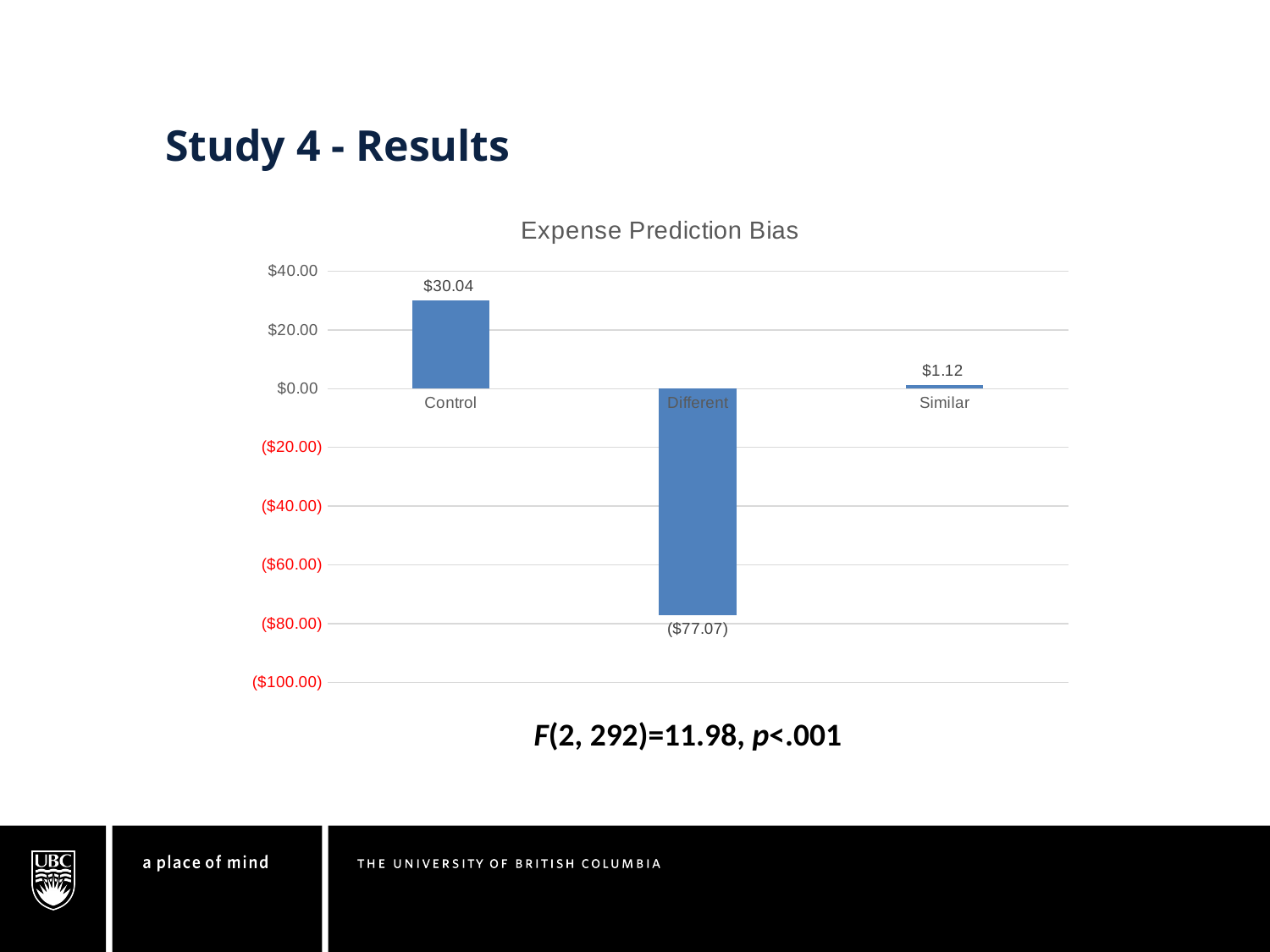
Which is larger, the value for Control or the value for Similar? Control What is the value for Control? $30.04 Is the value for Different greater or less than ($60.00)? less Which category has the highest value? Control What is the title of the chart? Expense Prediction Bias What is the value for Similar? $1.12 How many categories are shown on the chart? 3 What kind of chart is shown? bar chart Is the value for Control greater or less than $20.00? greater Which category has the lowest value? Different What is the difference between the values for Control and Similar? $28.92 What is the value for Different? ($77.07)